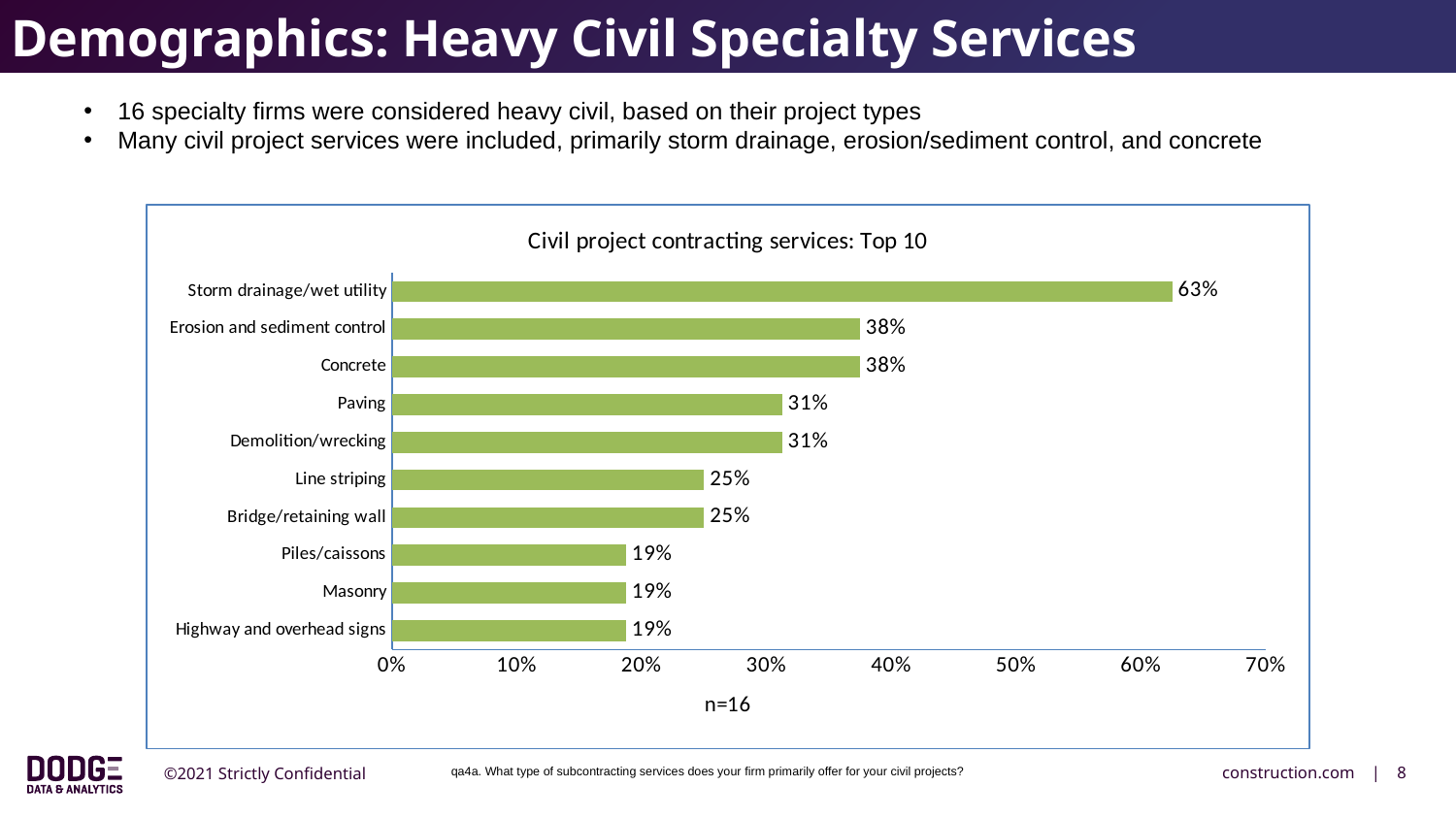
Is the value for Storm drainage/wet utility greater or less than 50%? greater What is the value for Masonry? 19% What is the difference between the values for Storm drainage/wet utility and Concrete? 25% What is the title of the chart? Civil project contracting services: Top 10 What is the value for Paving? 31% What is the difference between the values for Line striping and Piles/caissons? 6% Which is larger, the value for Erosion and sediment control or the value for Demolition/wrecking? Erosion and sediment control What is the value for Storm drainage/wet utility? 63% What kind of chart is shown on the slide? Bar chart Which category has the highest value? Storm drainage/wet utility What is the value for Bridge/retaining wall? 25% How many categories are shown in the chart? 10